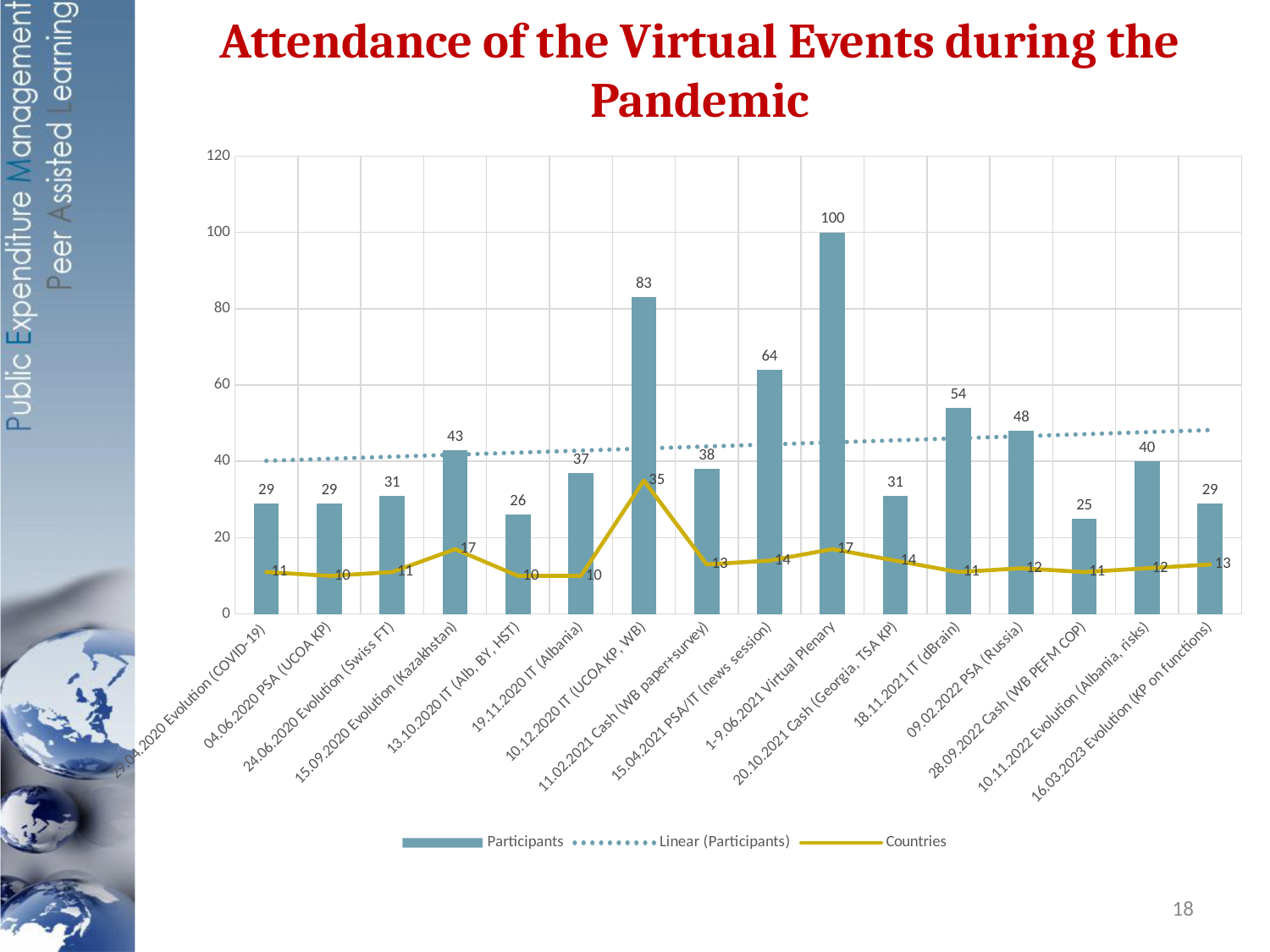
How many participants attended the 1-9.06.2021 Virtual Plenary? 100 How many participants attended the 18.11.2021 IT (dBrain) event? 54 How many events are shown on the x axis? 16 Which event had the highest number of participants? 1-9.06.2021 Virtual Plenary How many countries took part in the 10.12.2020 IT (UCOA KP, WB) event? 35 Which had more participants: 15.04.2021 PSA/IT (news session) or 09.02.2022 PSA (Russia)? 15.04.2021 PSA/IT (news session) Does the dotted Linear (Participants) trend line rise or fall from left to right? Rise What kind of chart is used to show the Participants series? Bar chart How many series does the legend list? 3 What is the difference in participants between the 1-9.06.2021 Virtual Plenary and the 10.12.2020 IT (UCOA KP, WB) event? 17 Which event had the lowest number of participants? 28.09.2022 Cash (WB PEFM COP) What is the title of the chart? Attendance of the Virtual Events during the Pandemic